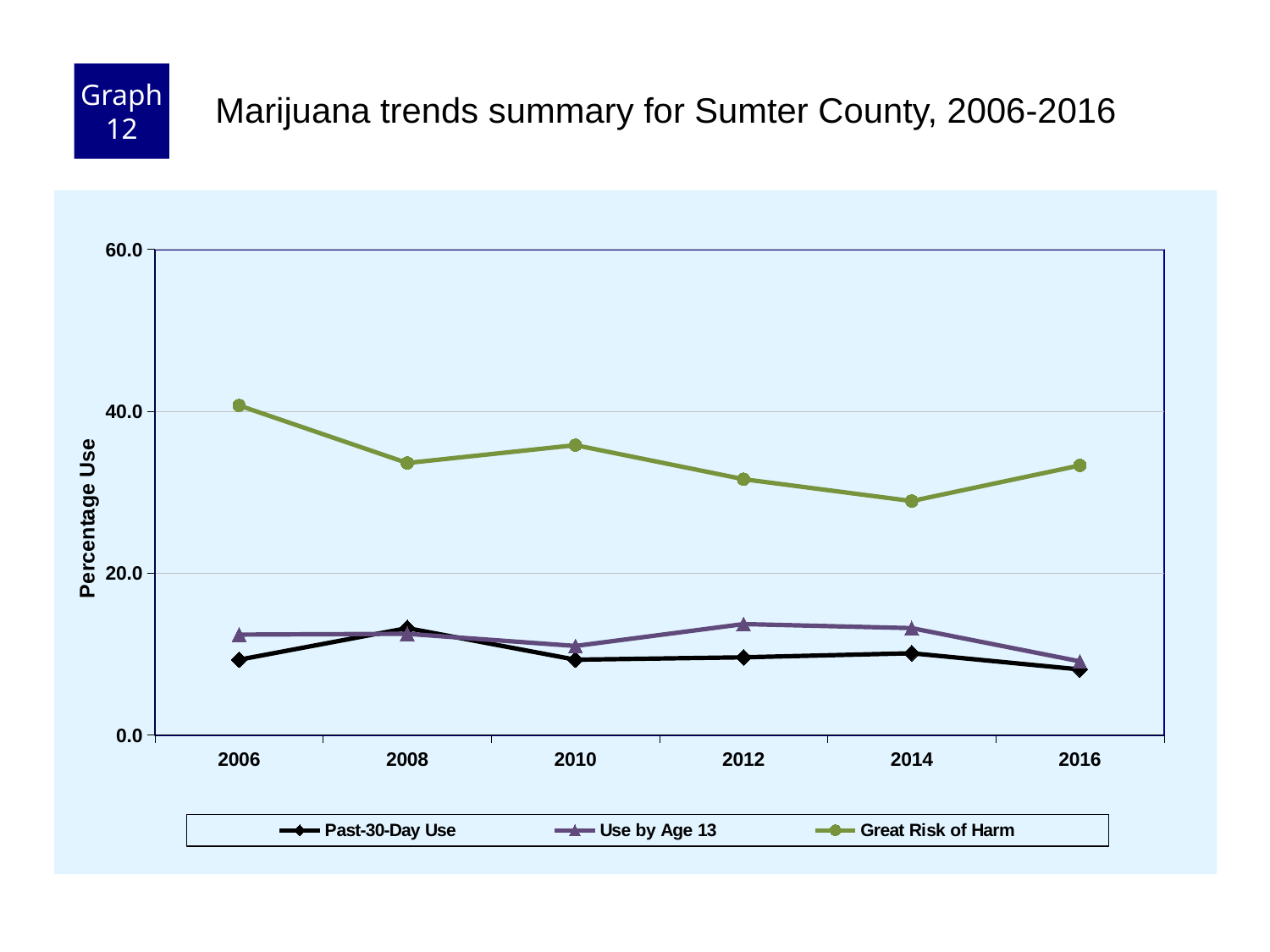
Does Great Risk of Harm rise or fall from 2006 to 2014? Fall Is the value for Past-30-Day Use in 2008 greater or less than 20.0? less What kind of chart is shown on the slide? Line chart Is the value for Great Risk of Harm in 2014 greater or less than 40.0? less How many years are plotted along the x axis? 6 Is the value for Great Risk of Harm in 2006 greater or less than 40.0? greater In which year is Great Risk of Harm highest? 2006 In which year is Use by Age 13 lowest? 2016 In 2006, which is larger: Use by Age 13 or Past-30-Day Use? Use by Age 13 In which year is Great Risk of Harm lowest? 2014 How many series does the legend list? 3 In which year is Past-30-Day Use highest? 2008